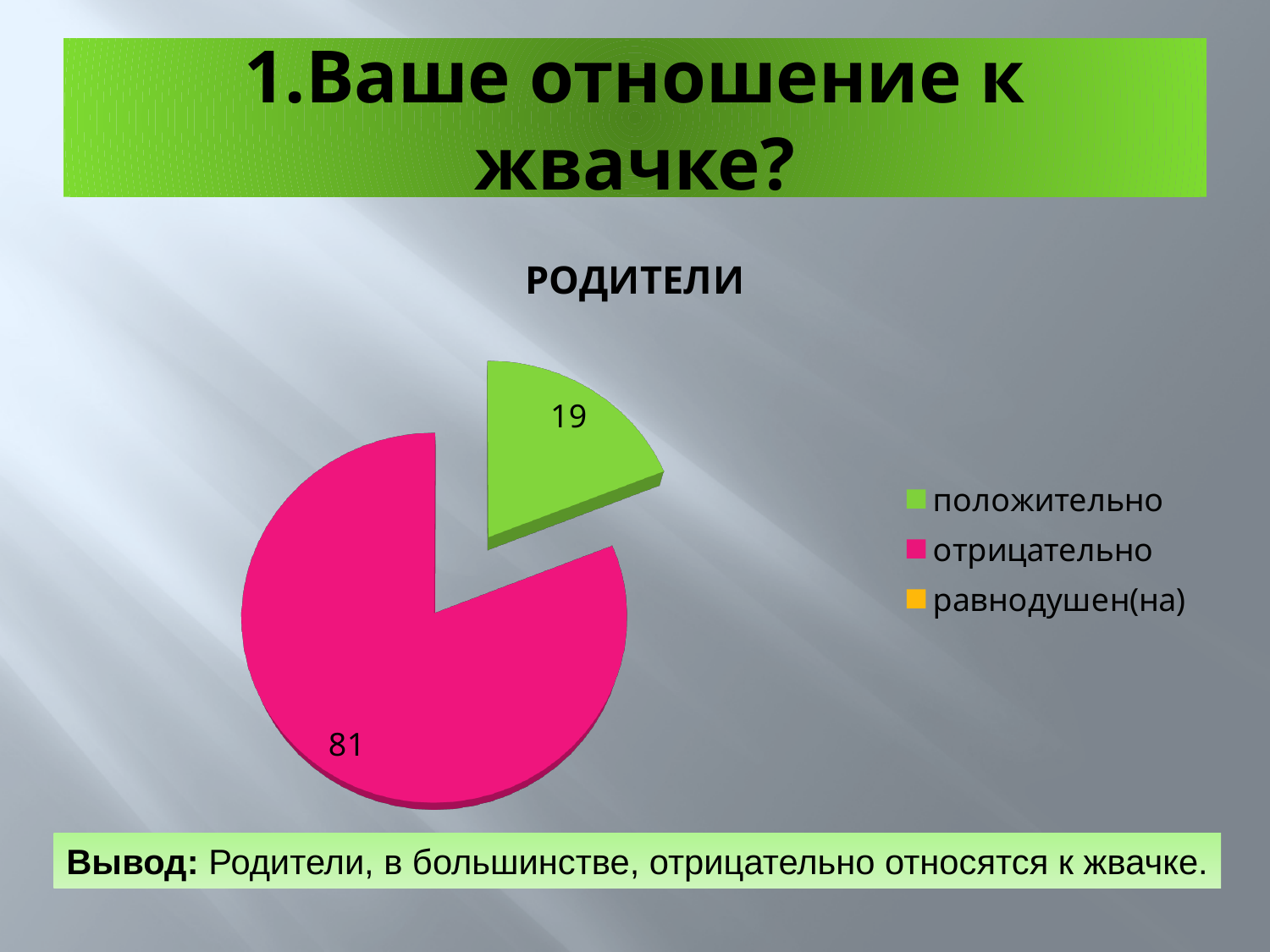
What is the difference between the 'отрицательно' and 'положительно' values? 62 What type of chart is shown on the slide? pie chart What colour is the 'отрицательно' slice? pink Which legend entry has no visible slice in the pie chart? равнодушен(на) How many slices are visible in the pie chart? 2 Which is larger, the value for 'положительно' or the value for 'отрицательно'? отрицательно Which of the labelled slices is the smallest? положительно What value is shown for the 'отрицательно' slice? 81 What value is shown for the 'положительно' slice? 19 Which category has the largest slice in the pie chart? отрицательно How many entries does the legend list? 3 What is the title of the chart? РОДИТЕЛИ